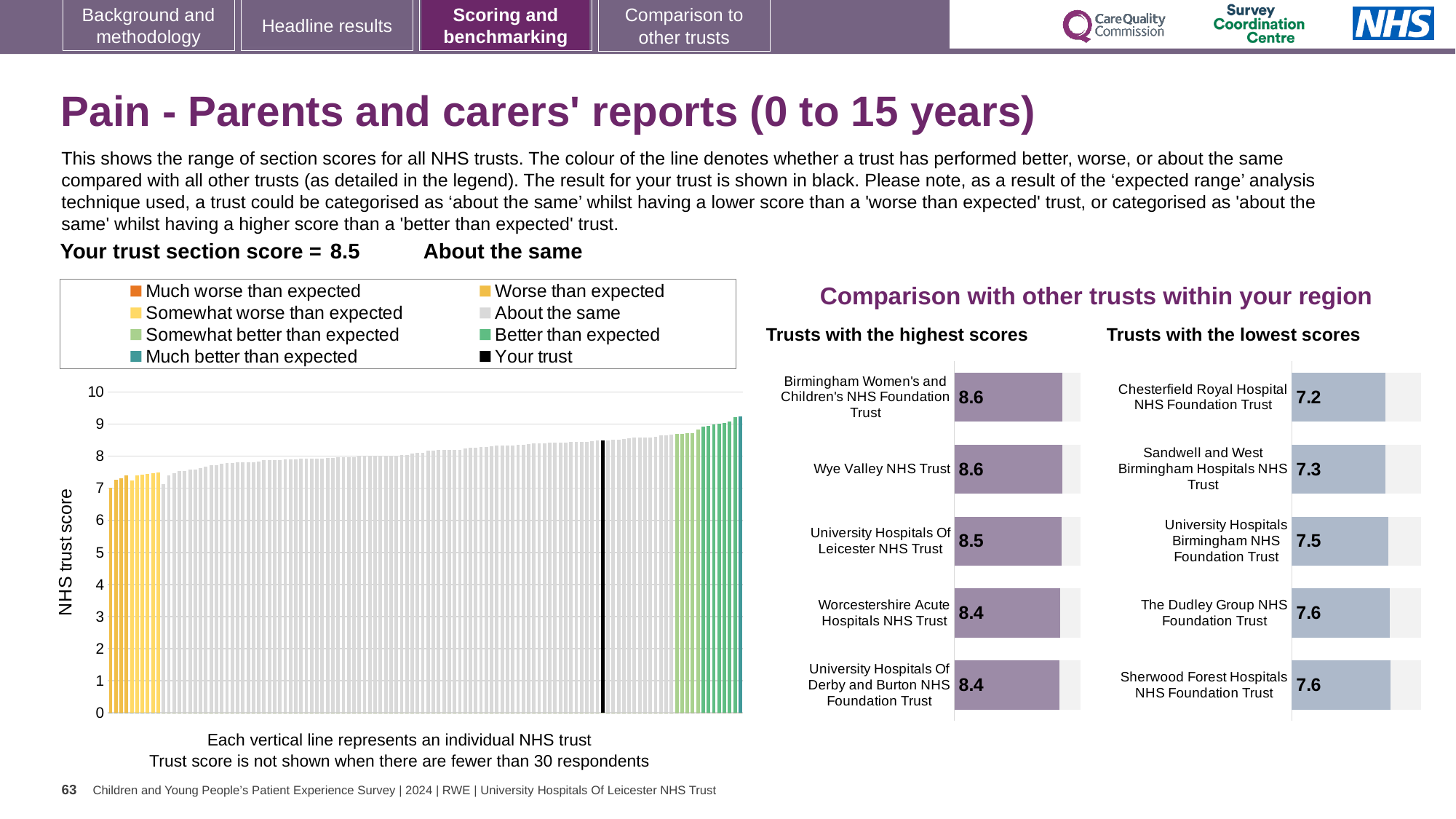
In the 'Trusts with the highest scores' chart, what is the difference between the score for Birmingham Women's and Children's NHS Foundation Trust and the score for University Hospitals Of Derby and Burton NHS Foundation Trust? 0.2 In the large chart on the left, is the value of the black bar (Your trust) greater or less than 8? greater In the large chart on the left, do the bars rise or fall from left to right? rise In the 'Trusts with the highest scores' chart, how many trusts are shown? 5 In the 'Trusts with the lowest scores' chart, which trust has the lowest score? Chesterfield Royal Hospital NHS Foundation Trust How many entries does the legend above the large chart on the left list? 8 What kind of chart is the large chart on the left of the slide, with the y axis labelled 'NHS trust score'? bar chart In the 'Trusts with the lowest scores' chart, what is the score for University Hospitals Birmingham NHS Foundation Trust? 7.5 In the 'Trusts with the highest scores' chart, which has the higher score: University Hospitals Of Leicester NHS Trust or Worcestershire Acute Hospitals NHS Trust? University Hospitals Of Leicester NHS Trust In the 'Trusts with the highest scores' chart, what is the score for Wye Valley NHS Trust? 8.6 In the 'Trusts with the lowest scores' chart, what is the difference between the score for Sherwood Forest Hospitals NHS Foundation Trust and the score for Chesterfield Royal Hospital NHS Foundation Trust? 0.4 What is the section score for your trust shown on the slide? 8.5